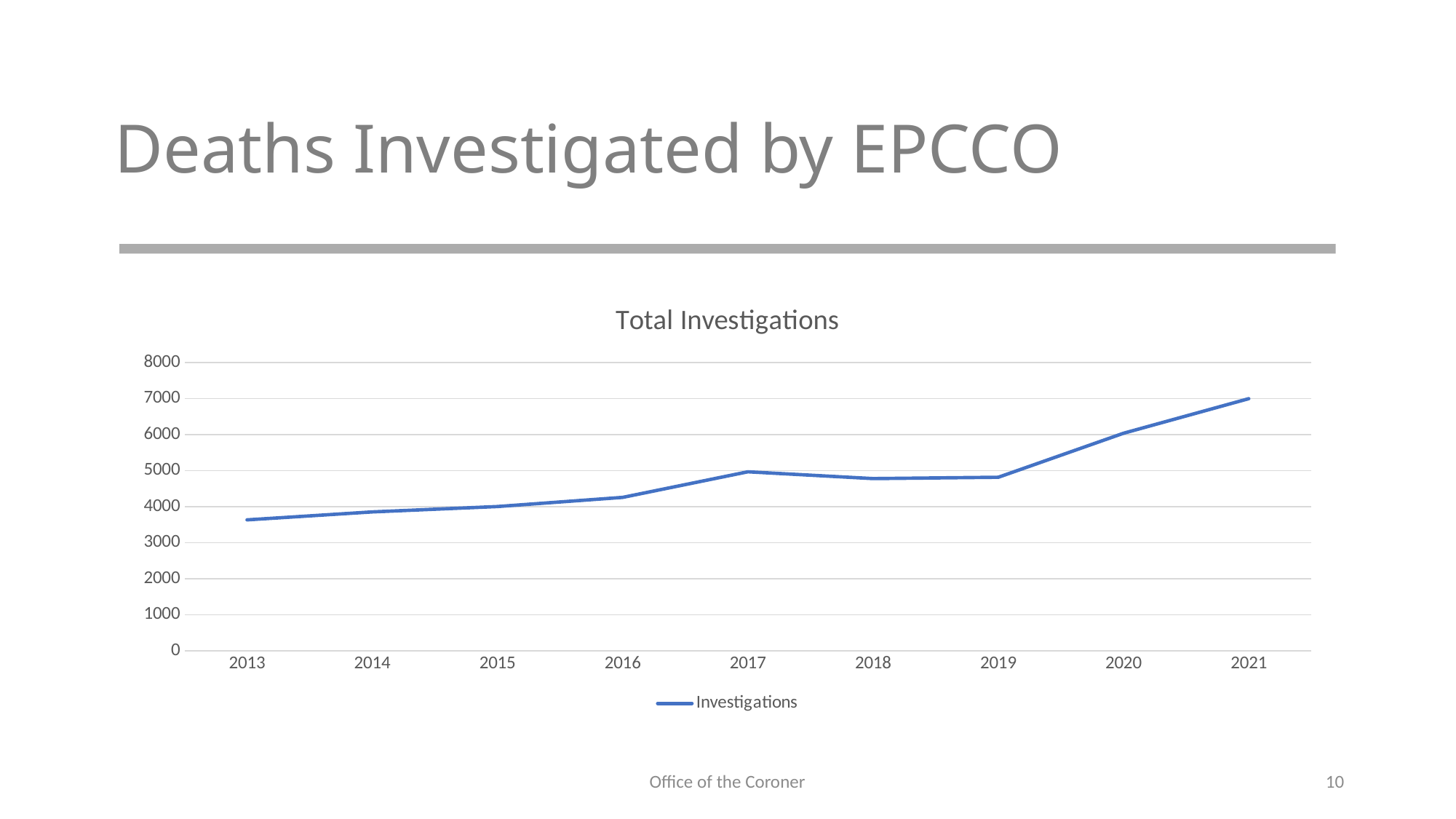
Which year has the lowest number of investigations? 2013 Which year has the highest number of investigations? 2021 Is the value for 2019 greater or less than 4000? greater How many series does the legend list? 1 Is the value for 2020 greater or less than 5000? greater Is the value for 2013 greater or less than 4000? less What is the title of the chart? Total Investigations What kind of chart is shown on the slide? line chart Which year has more investigations, 2020 or 2017? 2020 How many years are plotted on the x axis? 9 Do the investigation values generally rise or fall from 2013 to 2021? rise